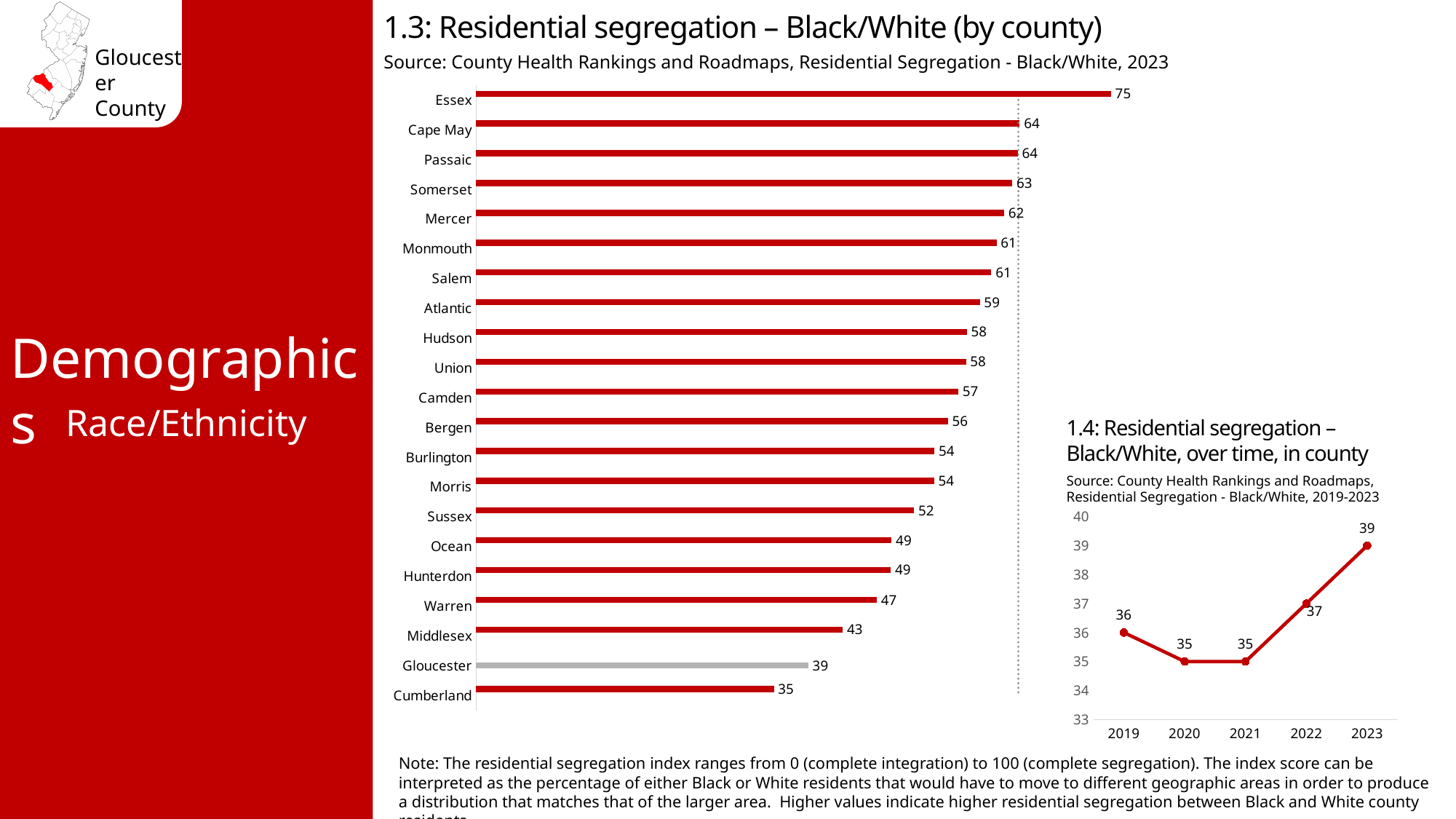
In the chart '1.3: Residential segregation – Black/White (by county)', what is the value for Camden? 57 In the chart '1.4: Residential segregation – Black/White, over time, in county', which year has the lowest value? 2020 and 2021 In the chart '1.4: Residential segregation – Black/White, over time, in county', what is the value for 2023? 39 What kind of chart is '1.3: Residential segregation – Black/White (by county)'? Bar chart In the chart '1.4: Residential segregation – Black/White, over time, in county', what is the difference between the values for 2023 and 2019? 3 In the chart '1.3: Residential segregation – Black/White (by county)', which county has the lowest value? Cumberland In the chart '1.3: Residential segregation – Black/White (by county)', what is the value for Gloucester? 39 In the chart '1.3: Residential segregation – Black/White (by county)', what is the difference between the values for Essex and Gloucester? 36 In the chart '1.3: Residential segregation – Black/White (by county)', how many counties are shown? 21 In the chart '1.3: Residential segregation – Black/White (by county)', which has a larger value, Middlesex or Warren? Warren What kind of chart is '1.4: Residential segregation – Black/White, over time, in county'? Line chart In the chart '1.3: Residential segregation – Black/White (by county)', which county has the highest value? Essex